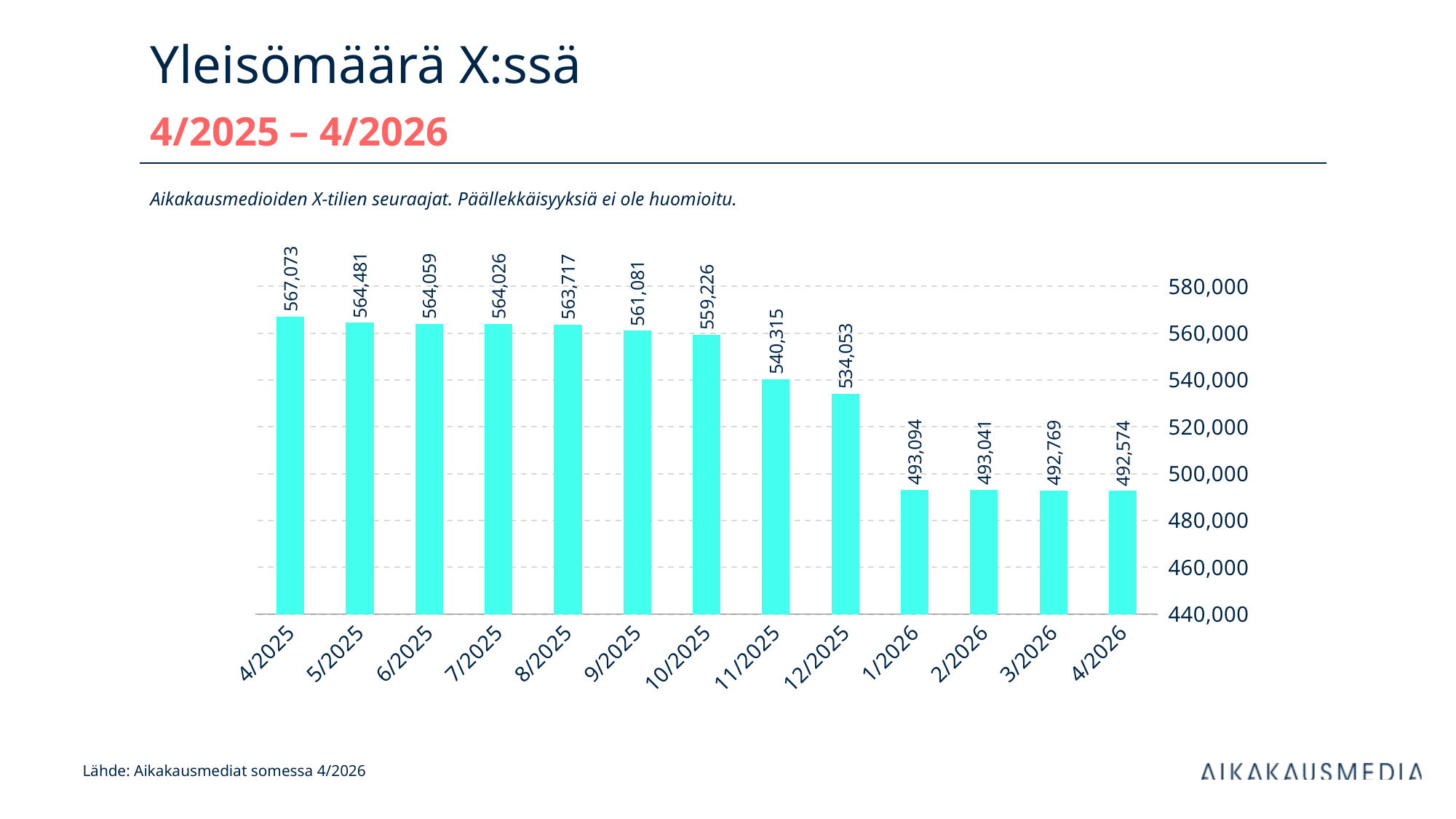
How many months are shown on the x axis? 13 Which month has the highest value? 4/2025 Which is larger, the value for 10/2025 or the value for 12/2025? 10/2025 Which month has the lowest value? 4/2026 What is the value for 11/2025? 540,315 Is the value for 1/2026 greater or less than 500,000? less Do the values rise or fall from 4/2025 to 4/2026? fall What is the difference between the values for 11/2025 and 12/2025? 6,262 What kind of chart is shown on the slide? bar chart What is the value for 4/2025? 567,073 What is the difference between the values for 4/2025 and 4/2026? 74,499 What is the value for 4/2026? 492,574